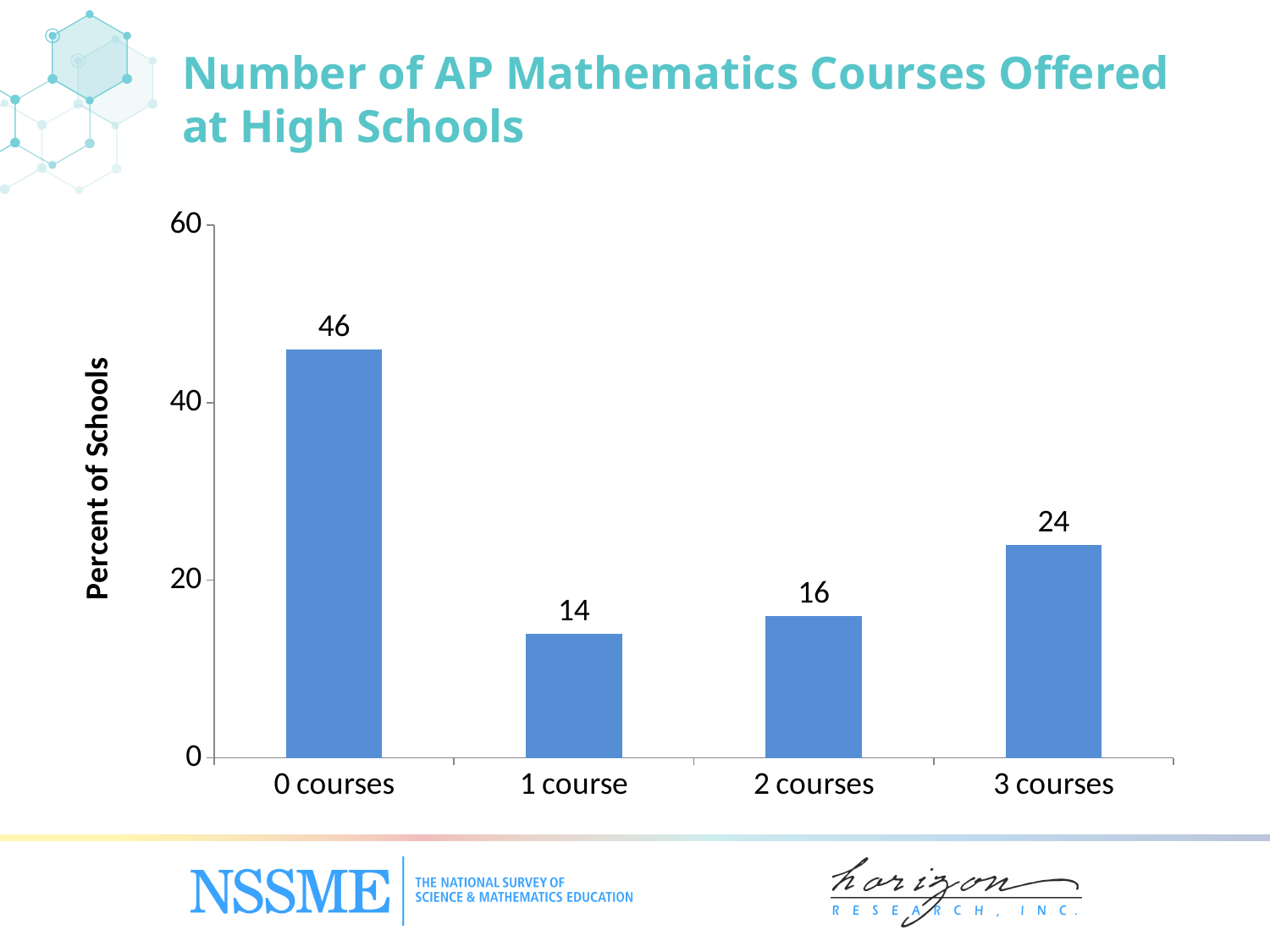
What percent of schools offer 1 AP mathematics course? 14 What kind of chart is shown on the slide? Bar chart Which category has the lowest percent of schools? 1 course How many categories are shown on the x axis? 4 What percent of schools offer 0 AP mathematics courses? 46 Which category has the highest percent of schools? 0 courses What percent of schools offer 2 AP mathematics courses? 16 What percent of schools offer 3 AP mathematics courses? 24 What is the label of the y axis? Percent of Schools Is the value for 3 courses greater or less than 20? greater What is the difference in percent of schools between 0 courses and 3 courses? 22 Which is larger, the percent of schools offering 2 courses or 3 courses? 3 courses